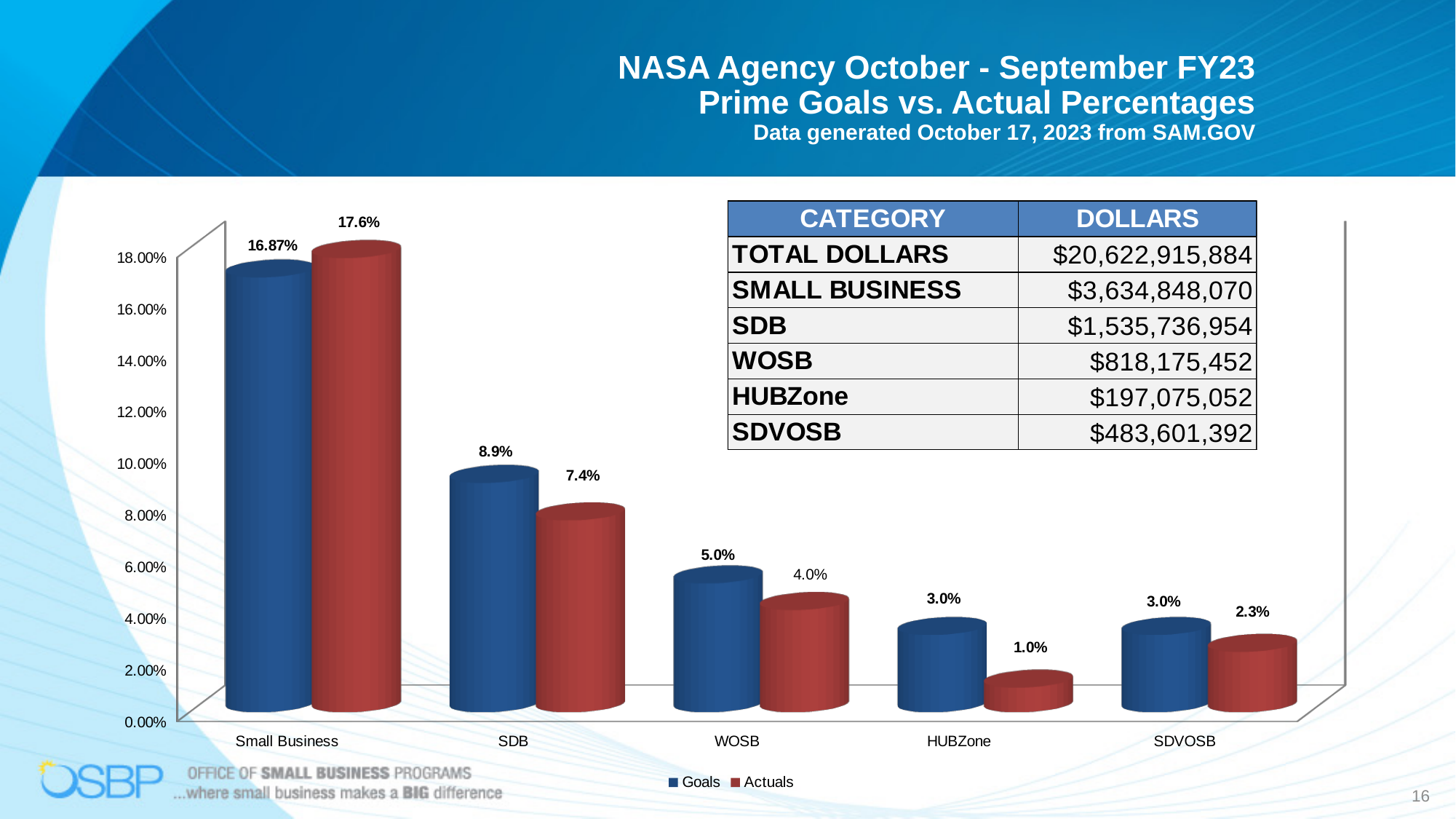
What is the Goals value for WOSB? 5.0% How many series does the chart legend list? 2 What kind of chart is shown on the slide? Bar chart Which category has the highest Actuals value? Small Business Which colour represents the Actuals series in the chart? Red How many categories are shown on the x axis of the chart? 5 What is the Actuals value for HUBZone? 1.0% Which is larger for Small Business, the Goals value or the Actuals value? Actuals What is the Goals value for Small Business? 16.87% What is the difference between the Goals and Actuals values for SDVOSB? 0.7% Which category has the lowest Actuals value? HUBZone What is the Actuals value for SDB? 7.4%